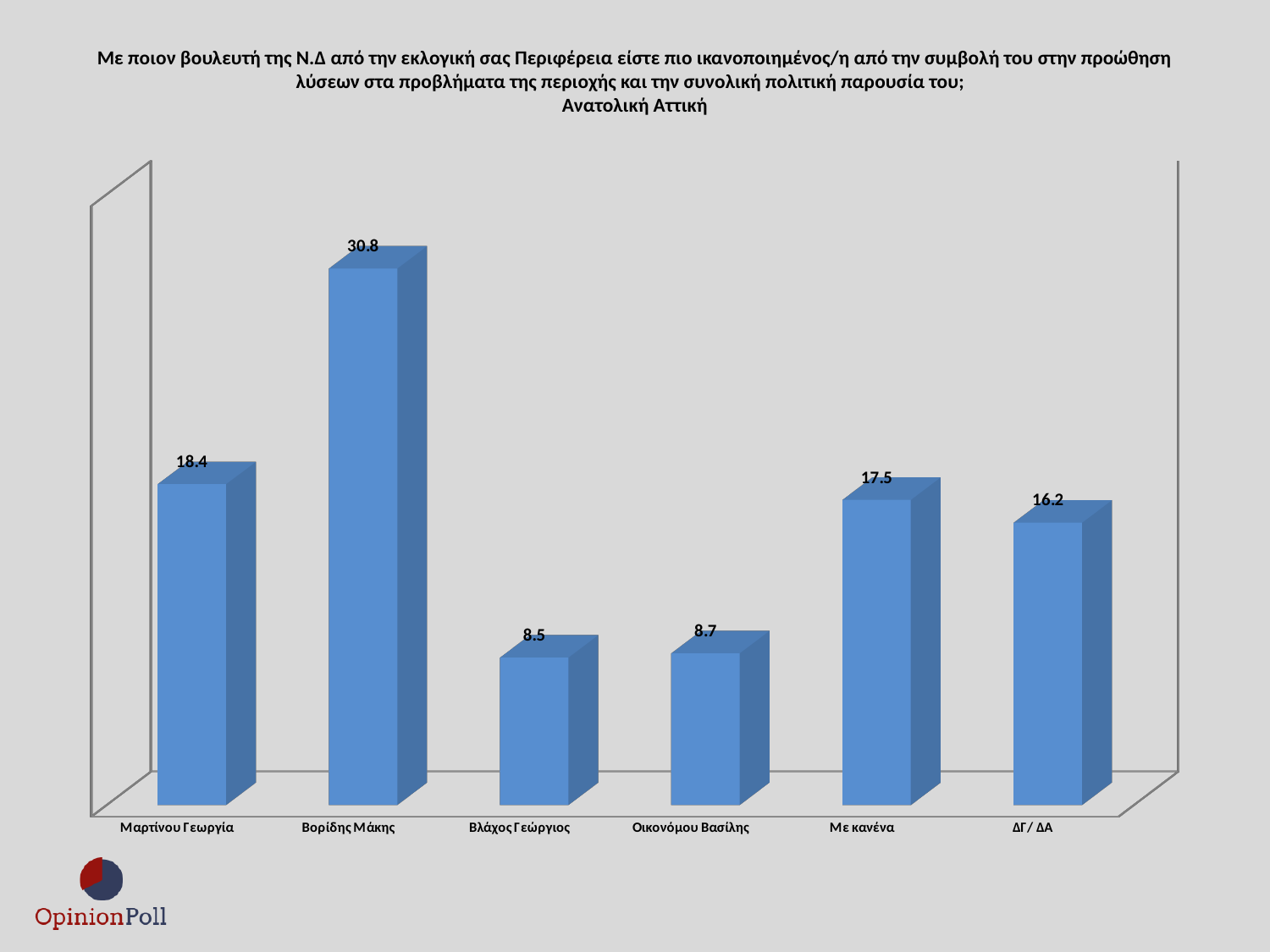
What is the difference between the values for Βορίδης Μάκης and Μαρτίνου Γεωργία? 12.4 What is the value for Με κανένα? 17.5 Which category has the lowest value? Βλάχος Γεώργιος Which category has the highest value? Βορίδης Μάκης What is the difference between the values for Με κανένα and ΔΓ/ ΔΑ? 1.3 What is the value for Μαρτίνου Γεωργία? 18.4 How many categories are shown on the x axis? 6 What is the value for ΔΓ/ ΔΑ? 16.2 Which region is named in the chart title? Ανατολική Αττική What kind of chart is shown on the slide? bar chart Which is larger, the value for Μαρτίνου Γεωργία or the value for Με κανένα? Μαρτίνου Γεωργία What is the value for Βορίδης Μάκης? 30.8